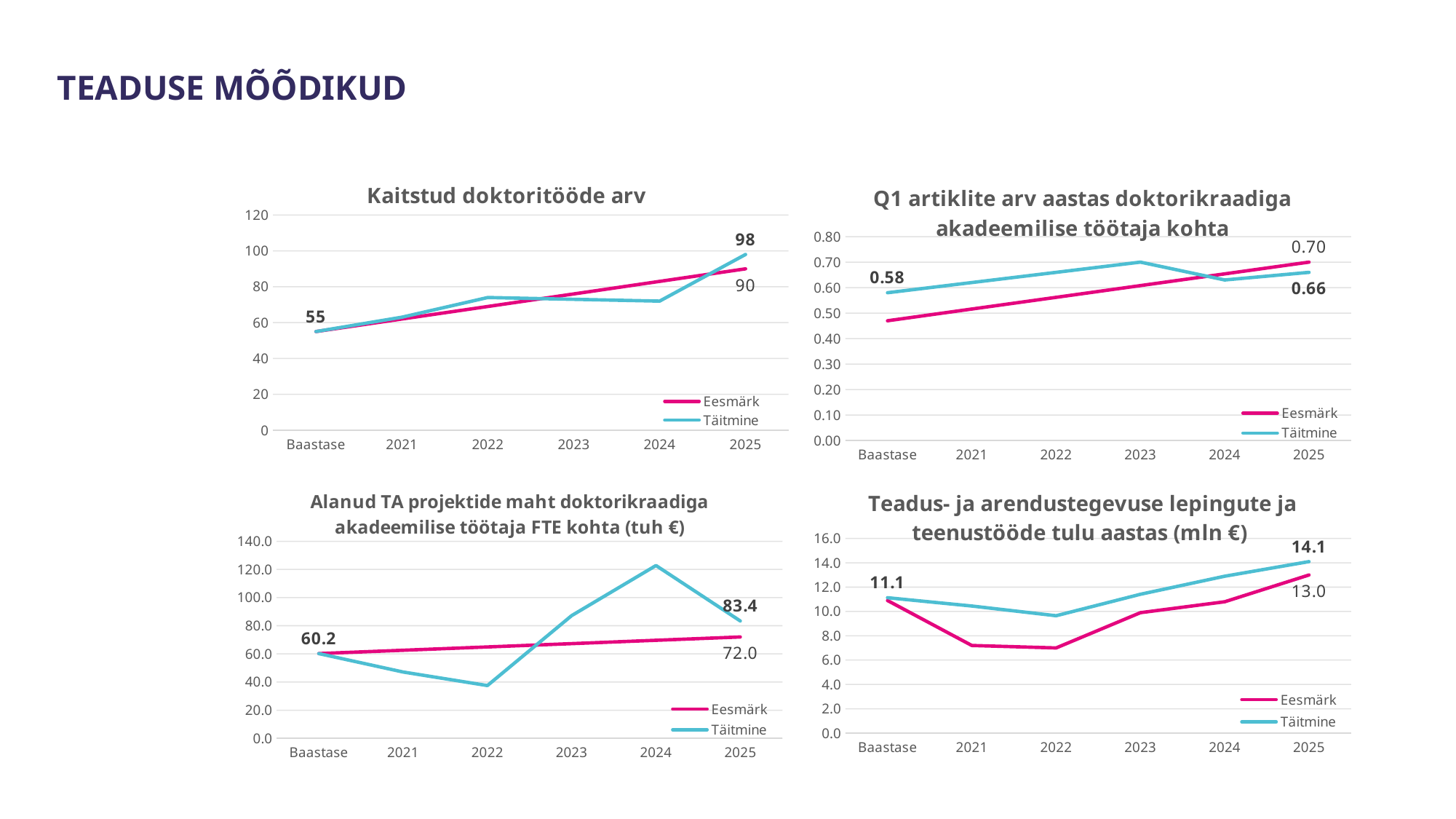
In the 'Teadus- ja arendustegevuse lepingute ja teenustööde tulu aastas (mln €)' chart, what is the Täitmine value for 2025? 14.1 In the 'Teadus- ja arendustegevuse lepingute ja teenustööde tulu aastas (mln €)' chart, is the Eesmärk value for 2022 greater or less than 8.0? less What kind of chart is the 'Kaitstud doktoritööde arv' chart? Line chart How many series does the legend list in the 'Kaitstud doktoritööde arv' chart? 2 In the 'Q1 artiklite arv aastas doktorikraadiga akadeemilise töötaja kohta' chart, what is the Baastase value? 0.58 How many points are on the x axis of the 'Teadus- ja arendustegevuse lepingute ja teenustööde tulu aastas (mln €)' chart? 6 In the 'Kaitstud doktoritööde arv' chart, what is the Täitmine value for 2025? 98 In the 'Q1 artiklite arv aastas doktorikraadiga akadeemilise töötaja kohta' chart, which is larger in 2025, Eesmärk or Täitmine? Eesmärk In the 'Alanud TA projektide maht doktorikraadiga akadeemilise töötaja FTE kohta (tuh €)' chart, what is the difference between the Täitmine and Eesmärk values in 2025? 11.4 In the 'Alanud TA projektide maht doktorikraadiga akadeemilise töötaja FTE kohta (tuh €)' chart, is the Täitmine value for 2024 greater or less than 100.0? greater In the 'Kaitstud doktoritööde arv' chart, what is the difference between the Täitmine and Eesmärk values in 2025? 8 In the 'Alanud TA projektide maht doktorikraadiga akadeemilise töötaja FTE kohta (tuh €)' chart, what is the Eesmärk value for 2025? 72.0